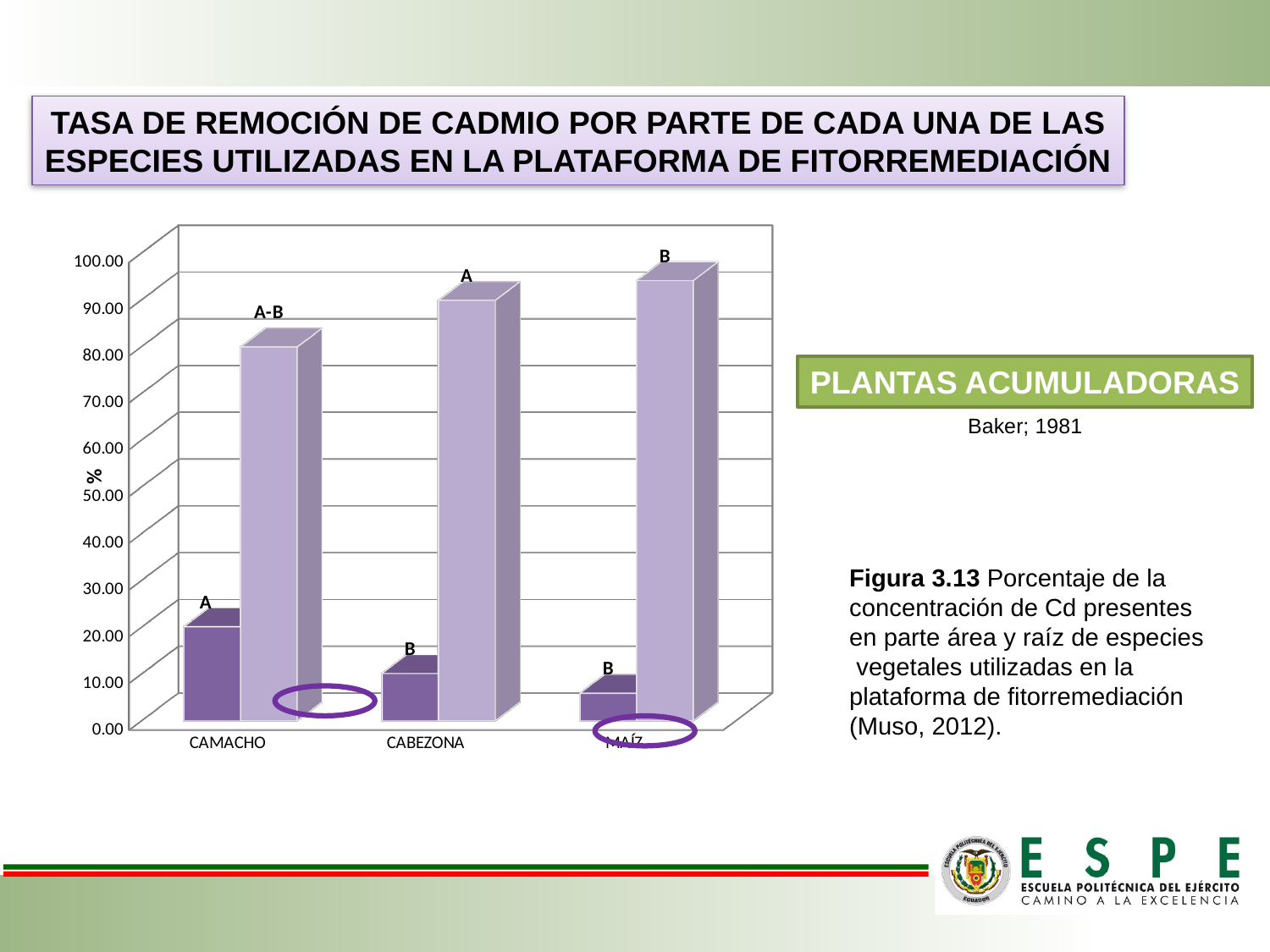
Which category has the tallest light purple bar? MAÍZ Which category has the shortest dark purple bar? MAÍZ Is the value of the dark purple bar for MAÍZ greater or less than 10.00? less Which category has the tallest dark purple bar? CAMACHO Is the value of the light purple bar for MAÍZ greater or less than 90.00? greater What kind of chart is shown on the slide? bar chart What label is printed on the y axis of the chart? % Do the dark purple bars rise or fall from CAMACHO to MAÍZ? fall Is the value of the dark purple bar for CAMACHO greater or less than 30.00? less For CAMACHO, which bar is larger, the dark purple bar or the light purple bar? the light purple bar How many categories are shown on the x axis of the chart? 3